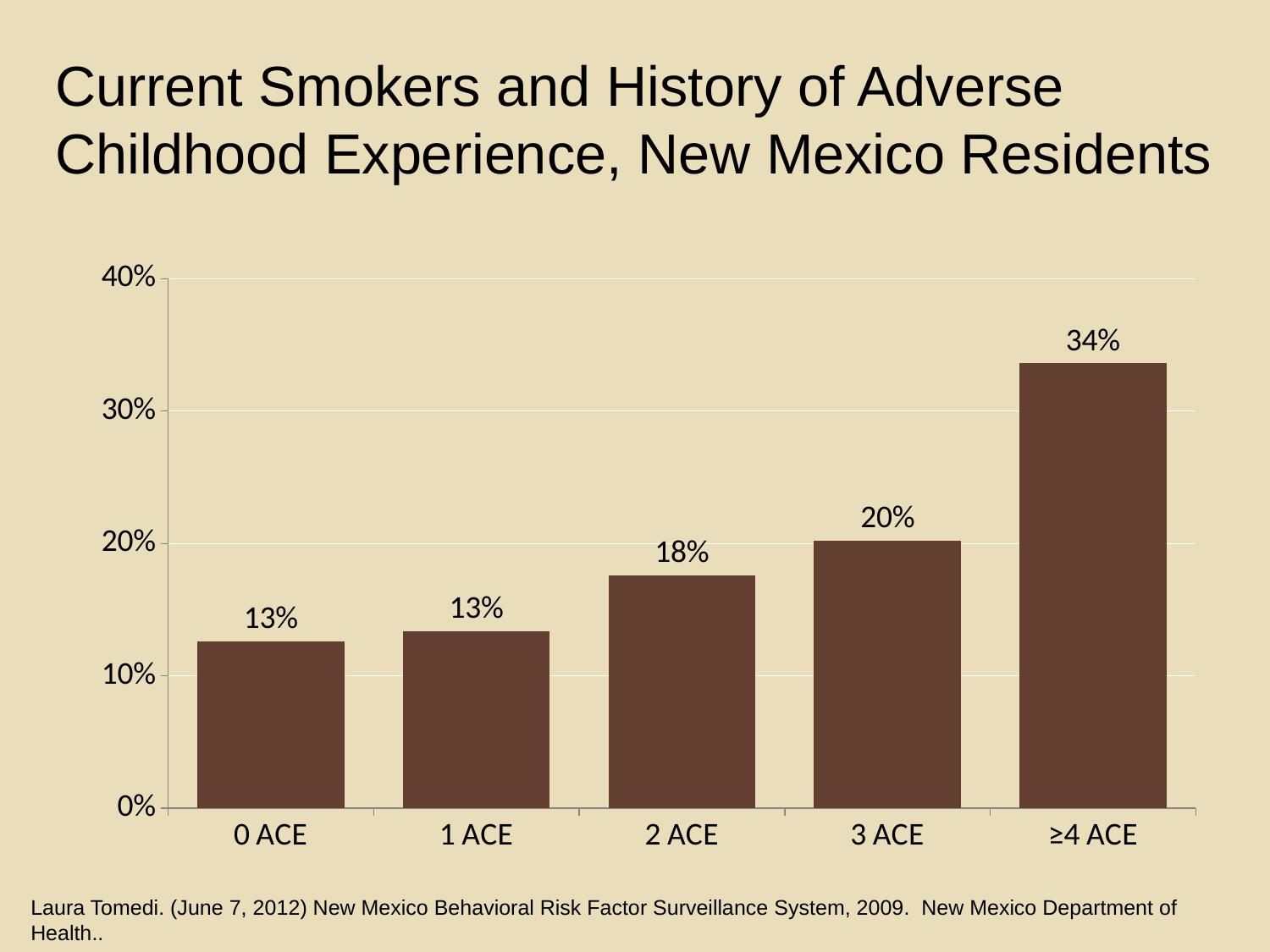
Do the values rise or fall from 0 ACE to ≥4 ACE? rise Is the value for ≥4 ACE greater or less than 30%? greater How many categories are shown on the x axis? 5 Which category has the highest value? ≥4 ACE What kind of chart is shown on the slide? bar chart What is the value for 0 ACE? 13% What is the value for 3 ACE? 20% What is the value for ≥4 ACE? 34% What is the difference between the values for ≥4 ACE and 3 ACE? 14% What is the value for 2 ACE? 18% What is the difference between the values for 2 ACE and 0 ACE? 5% Which is larger, the value for 3 ACE or the value for 2 ACE? 3 ACE